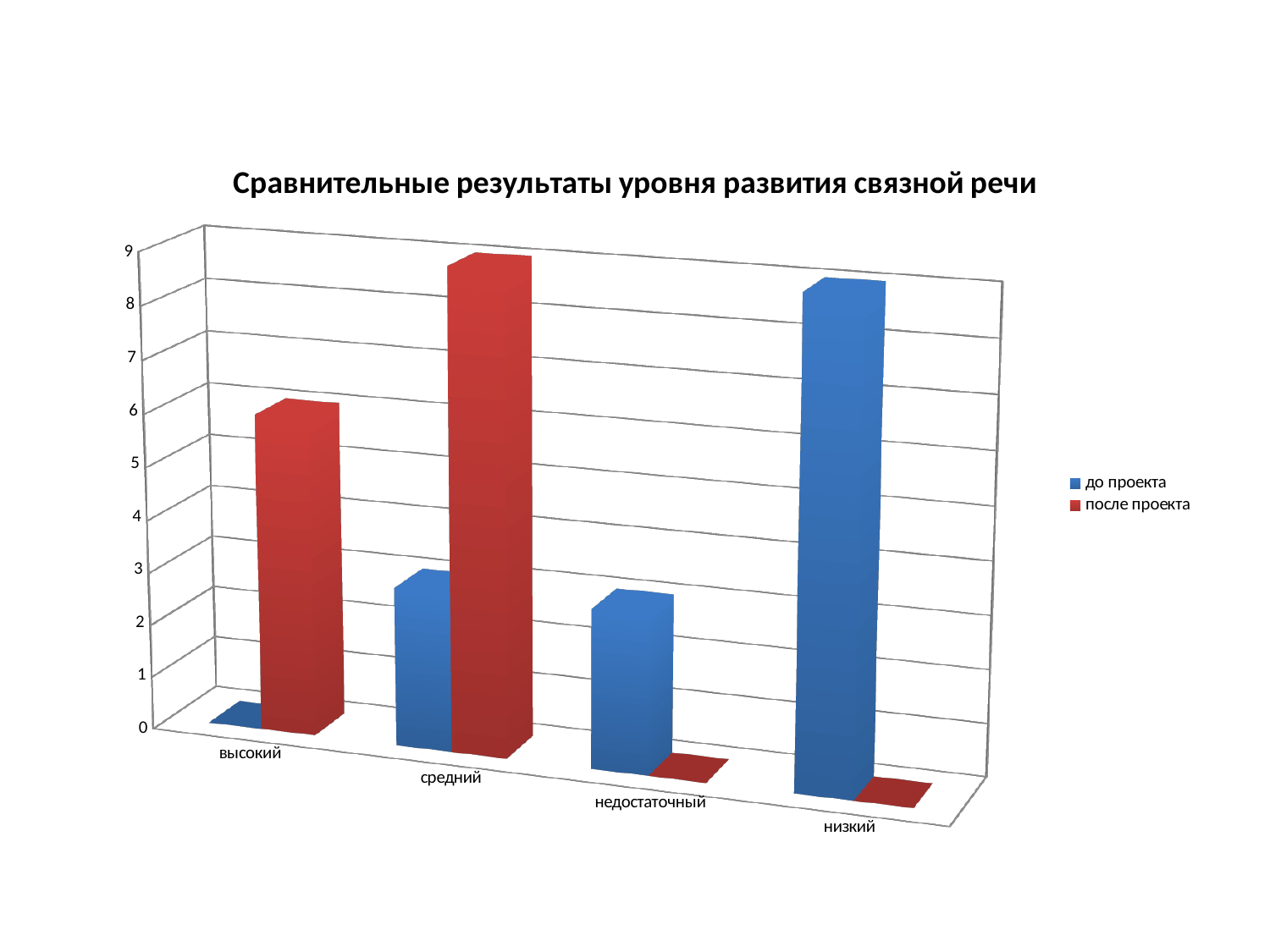
Is the value for 'высокий' in the series 'до проекта' greater or less than 2? less What kind of chart is shown on the slide? bar chart Is the value for 'высокий' in the series 'после проекта' greater or less than 3? greater For the category 'низкий', which series has the larger value: 'до проекта' or 'после проекта'? до проекта How many categories are shown on the x axis of the chart? 4 Which category has the lowest value for the series 'до проекта'? высокий Which category has the highest value for the series 'до проекта'? низкий Which category has the highest value for the series 'после проекта'? средний Is the value for 'низкий' in the series 'до проекта' greater or less than 5? greater What is the title of the chart? Сравнительные результаты уровня развития связной речи How many series does the legend list? 2 For the category 'высокий', which series has the larger value: 'до проекта' or 'после проекта'? после проекта